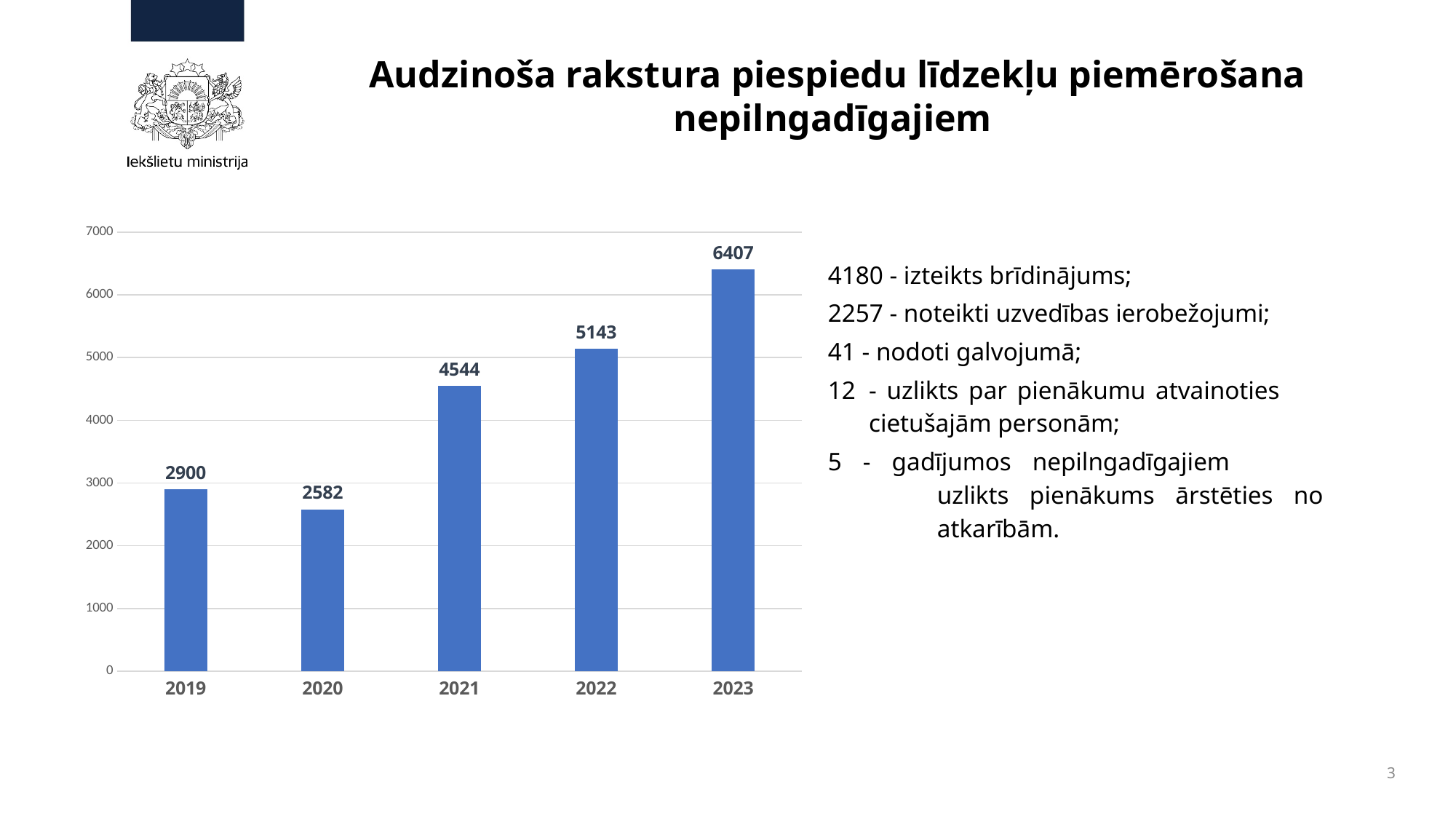
Which is larger, the value for 2021 or the value for 2022? 2022 Do the values rise or fall from 2020 to 2023? rise Which year has the highest value? 2023 What is the difference between the values for 2023 and 2022? 1264 What is the value for 2021? 4544 What is the value for 2023? 6407 How many years are shown on the x axis? 5 What kind of chart is shown on the slide? bar chart Which year has the lowest value? 2020 What is the difference between the values for 2019 and 2020? 318 Is the value for 2022 greater or less than 5000? greater What is the value for 2019? 2900